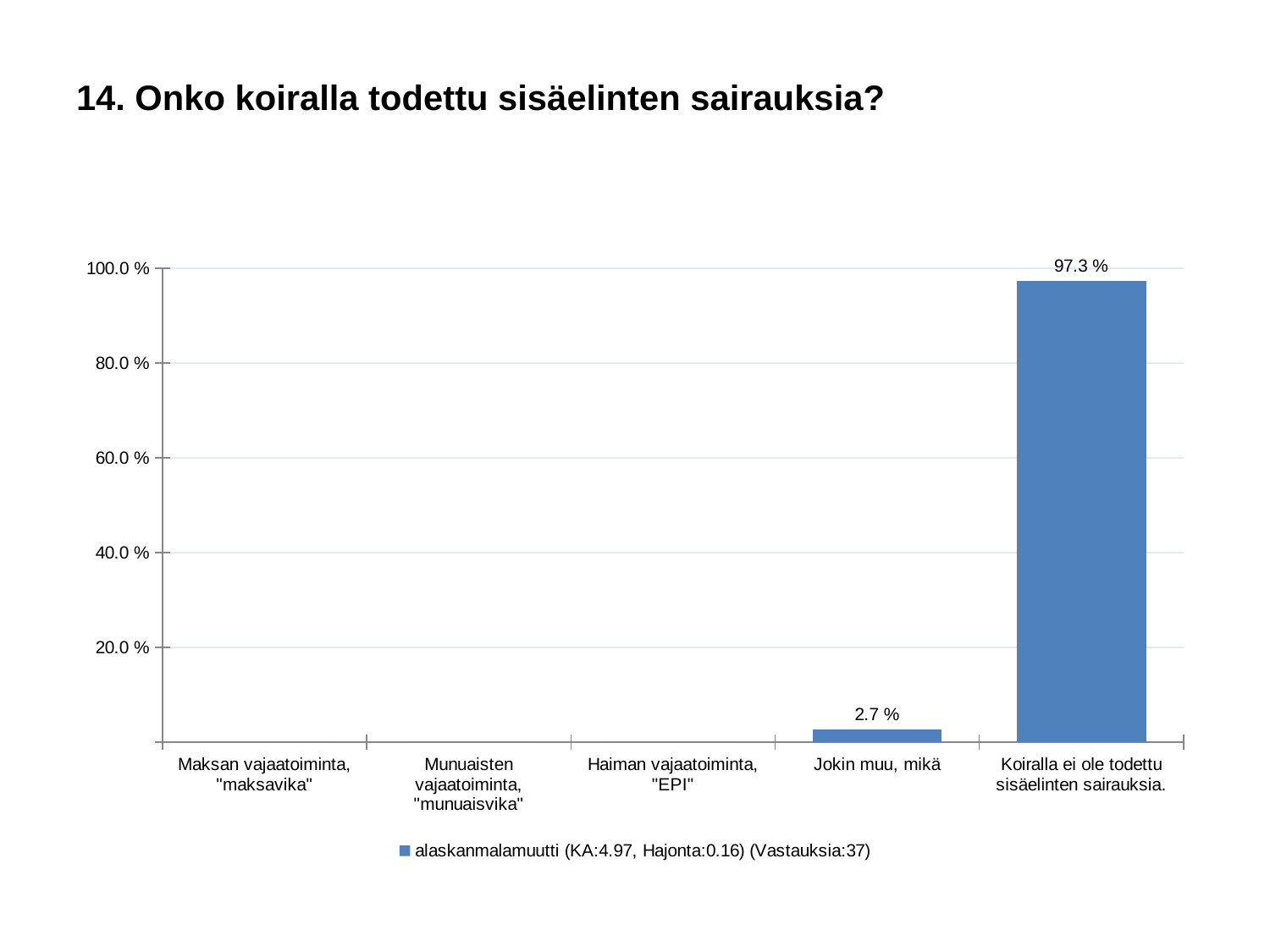
What kind of chart is shown on the slide? bar chart How many series does the legend list? 1 What is the title of the chart? 14. Onko koiralla todettu sisäelinten sairauksia? What is the value for "Koiralla ei ole todettu sisäelinten sairauksia."? 97.3 % Which is larger: the value for "Jokin muu, mikä" or the value for "Koiralla ei ole todettu sisäelinten sairauksia."? Koiralla ei ole todettu sisäelinten sairauksia. Which category has the highest value? Koiralla ei ole todettu sisäelinten sairauksia. What is the difference between the values for "Koiralla ei ole todettu sisäelinten sairauksia." and "Jokin muu, mikä"? 94.6 % How many responses (Vastauksia) does the legend entry report? 37 How many categories are shown on the x axis? 5 What is the value for "Jokin muu, mikä"? 2.7 % Is the value for "Koiralla ei ole todettu sisäelinten sairauksia." greater or less than 80.0 %? greater Is the value for "Jokin muu, mikä" greater or less than 20.0 %? less